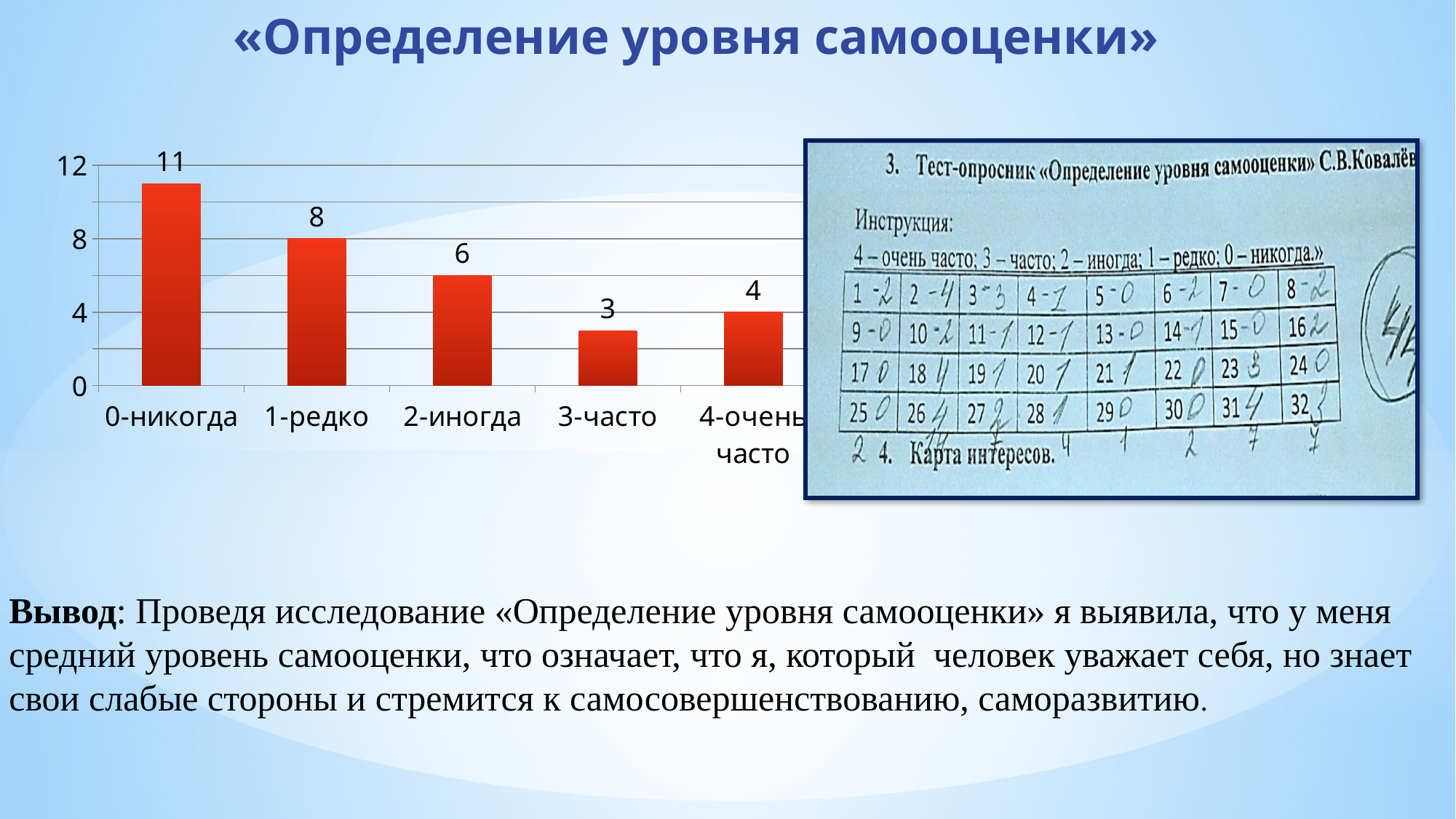
How many categories are shown on the x axis of the chart? 5 Which category has the highest value? 0-никогда What is the value for the category 1-редко? 8 What is the value for the category 3-часто? 3 Which category has the lowest value? 3-часто What colour are the bars in the chart? red What is the value for the category 4-очень часто? 4 What kind of chart is shown on the slide? bar chart What is the value for the category 2-иногда? 6 What is the value for the category 0-никогда? 11 What is the difference between the values for 0-никогда and 1-редко? 3 Which is larger, the value for 2-иногда or the value for 4-очень часто? 2-иногда